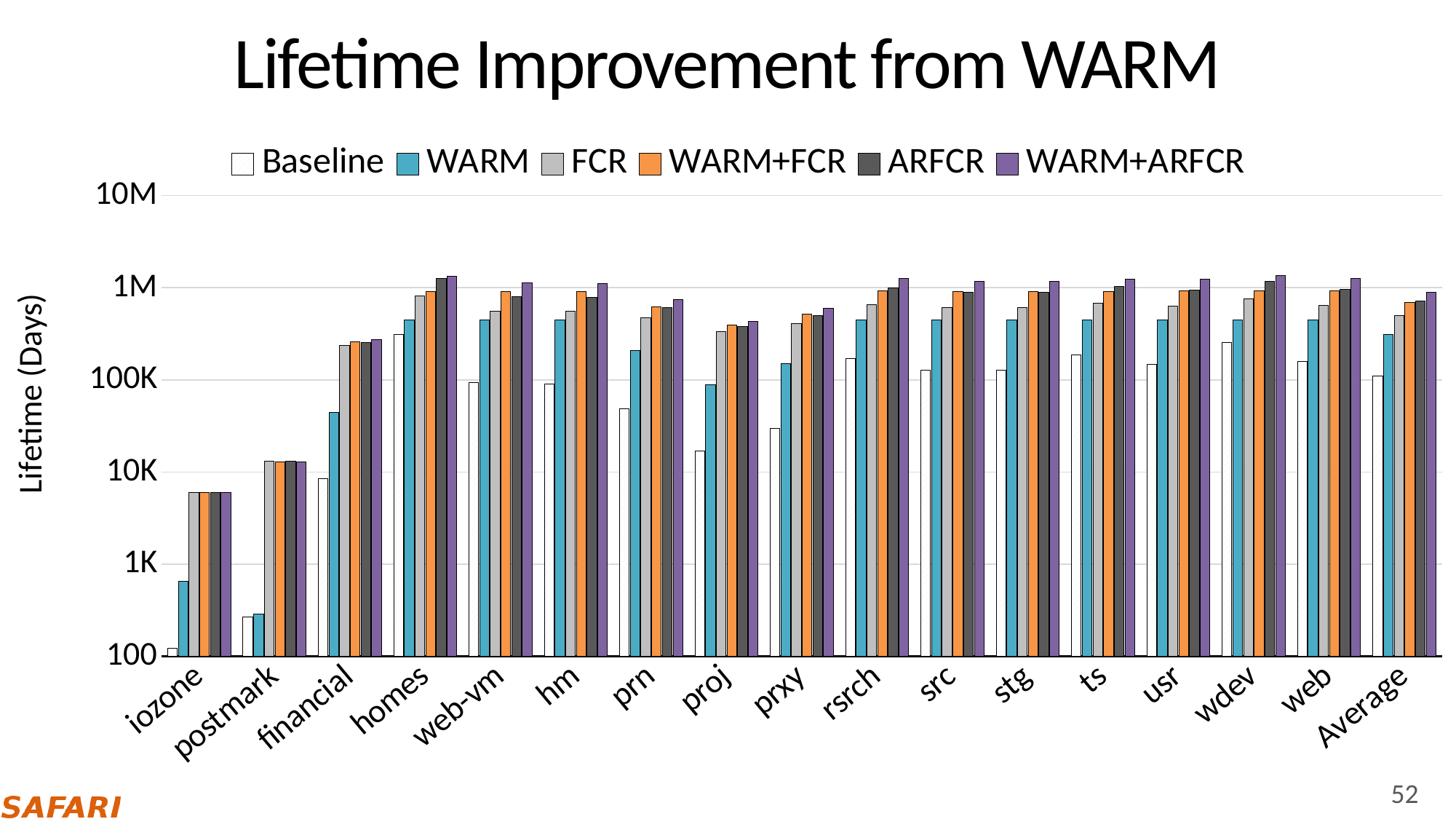
Is the Baseline value for prn greater or less than 100K? less What kind of chart is shown on the slide? bar chart Which is larger, the Baseline value for homes or the Baseline value for web-vm? homes How many categories are shown along the x axis? 17 How many series does the legend list? 6 Is the Baseline value for postmark greater or less than 1K? less What is the title of the chart? Lifetime Improvement from WARM Is the Baseline value for homes greater or less than 100K? greater What is the label of the y axis? Lifetime (Days) Which category has the lowest Baseline value? iozone